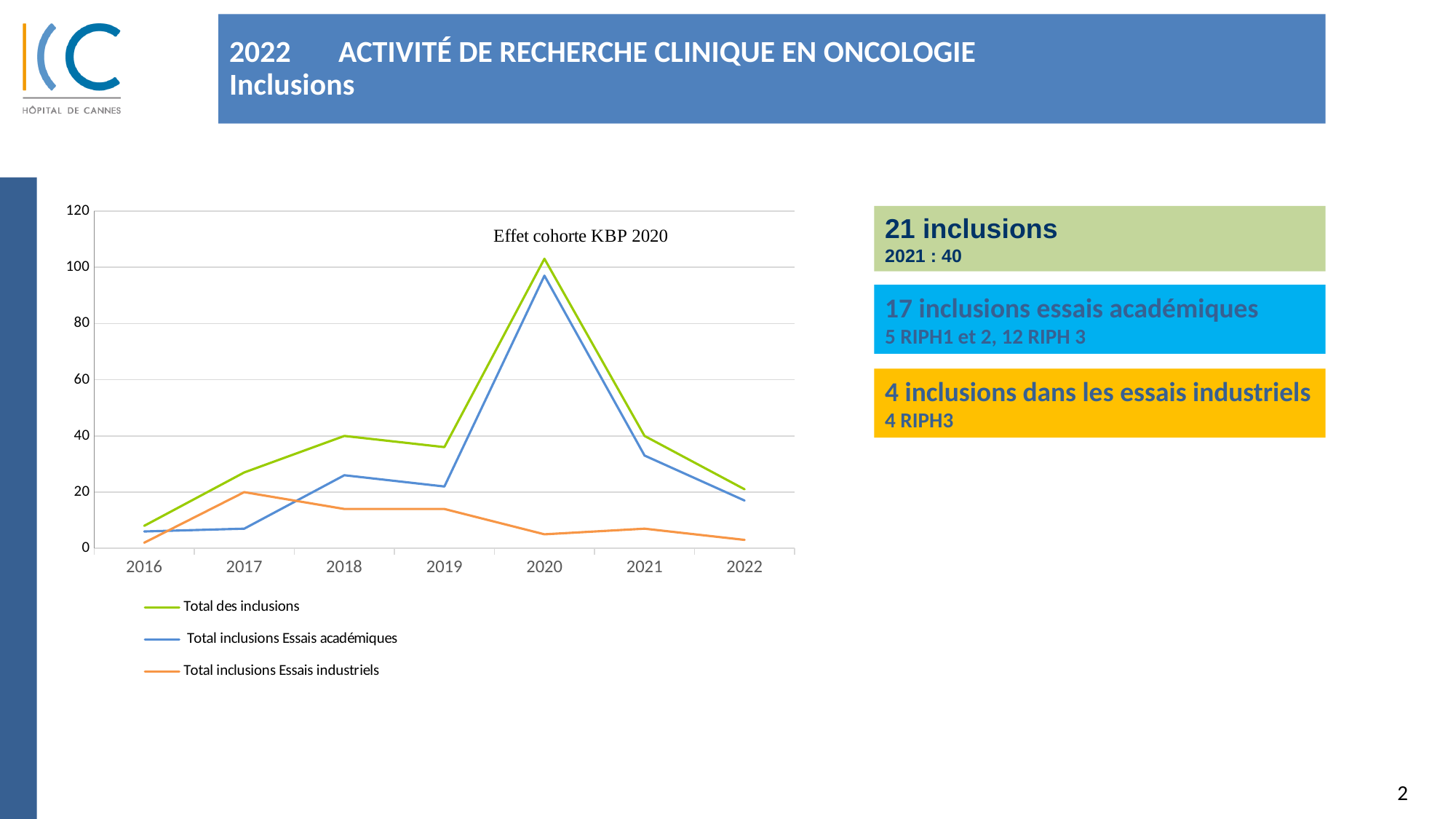
What annotation text is written inside the chart area near the 2020 peak? Effet cohorte KBP 2020 In which year does the 'Total inclusions Essais industriels' line reach its highest value? 2017 In 2020, which is larger: 'Total des inclusions' or 'Total inclusions Essais académiques'? Total des inclusions In which year does the 'Total des inclusions' line reach its highest value? 2020 Is the value for 'Total inclusions Essais industriels' in 2020 greater or less than 20? less What is the value of 'Total inclusions Essais industriels' in 2017? 20 How many series does the legend list? 3 Does the 'Total des inclusions' line rise or fall from 2020 to 2022? fall Is the value for 'Total inclusions Essais académiques' in 2020 greater or less than 80? greater What is the value of 'Total des inclusions' in 2021? 40 How many years are shown on the x axis? 7 What kind of chart is shown on the slide? line chart